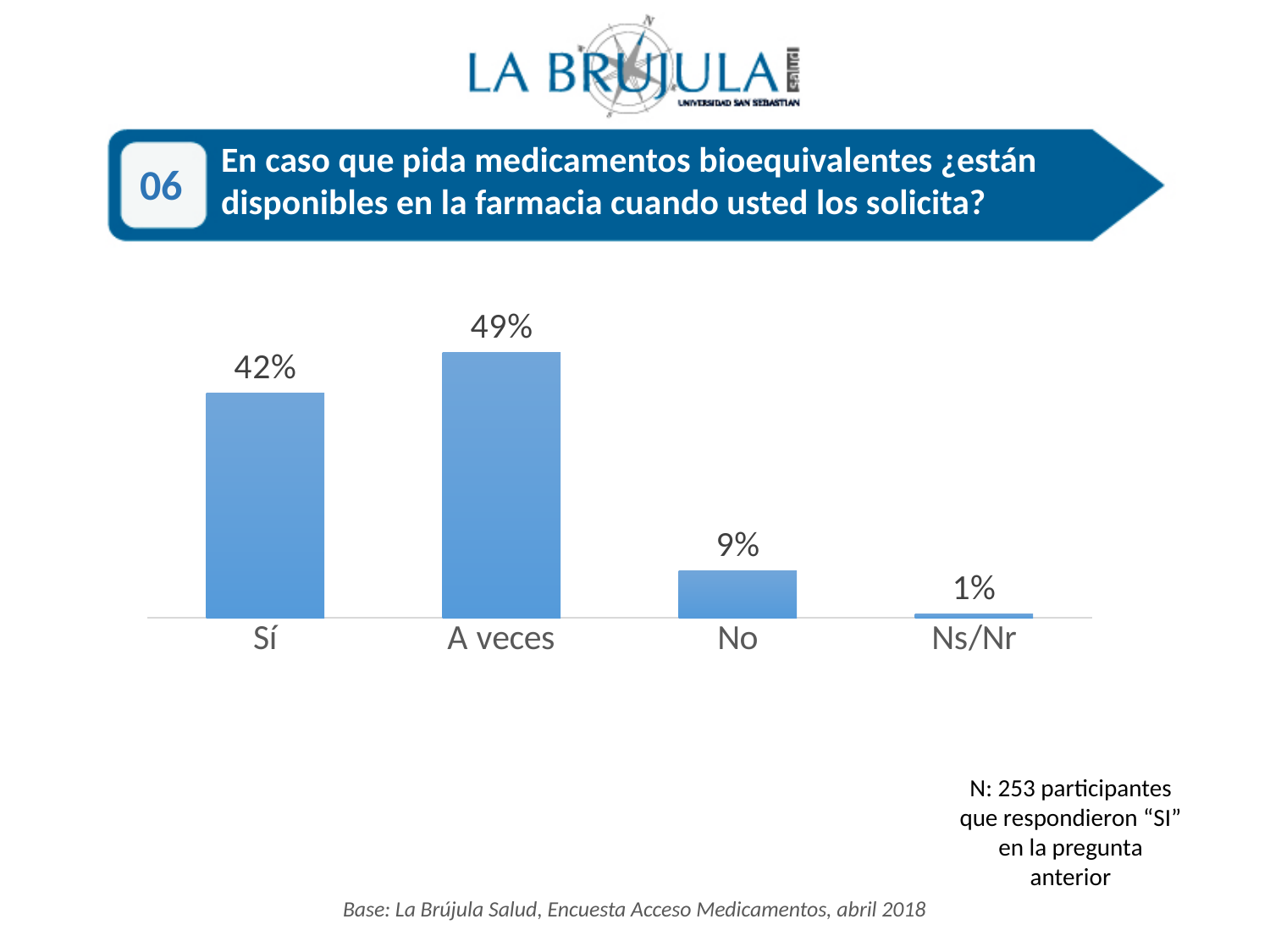
Which category has the lowest value? Ns/Nr What is the value for "A veces"? 49% What is the value for "Ns/Nr"? 1% What is the difference between the values for "A veces" and "Sí"? 7% Which is larger, the value for "Sí" or the value for "No"? Sí What is the number of participants (N) stated on the slide? 253 What is the value for "Sí"? 42% Which category has the highest value? A veces What is the value for "No"? 9% How many categories are shown in the chart? 4 What kind of chart is shown on the slide? Bar chart What is the difference between the values for "No" and "Ns/Nr"? 8%